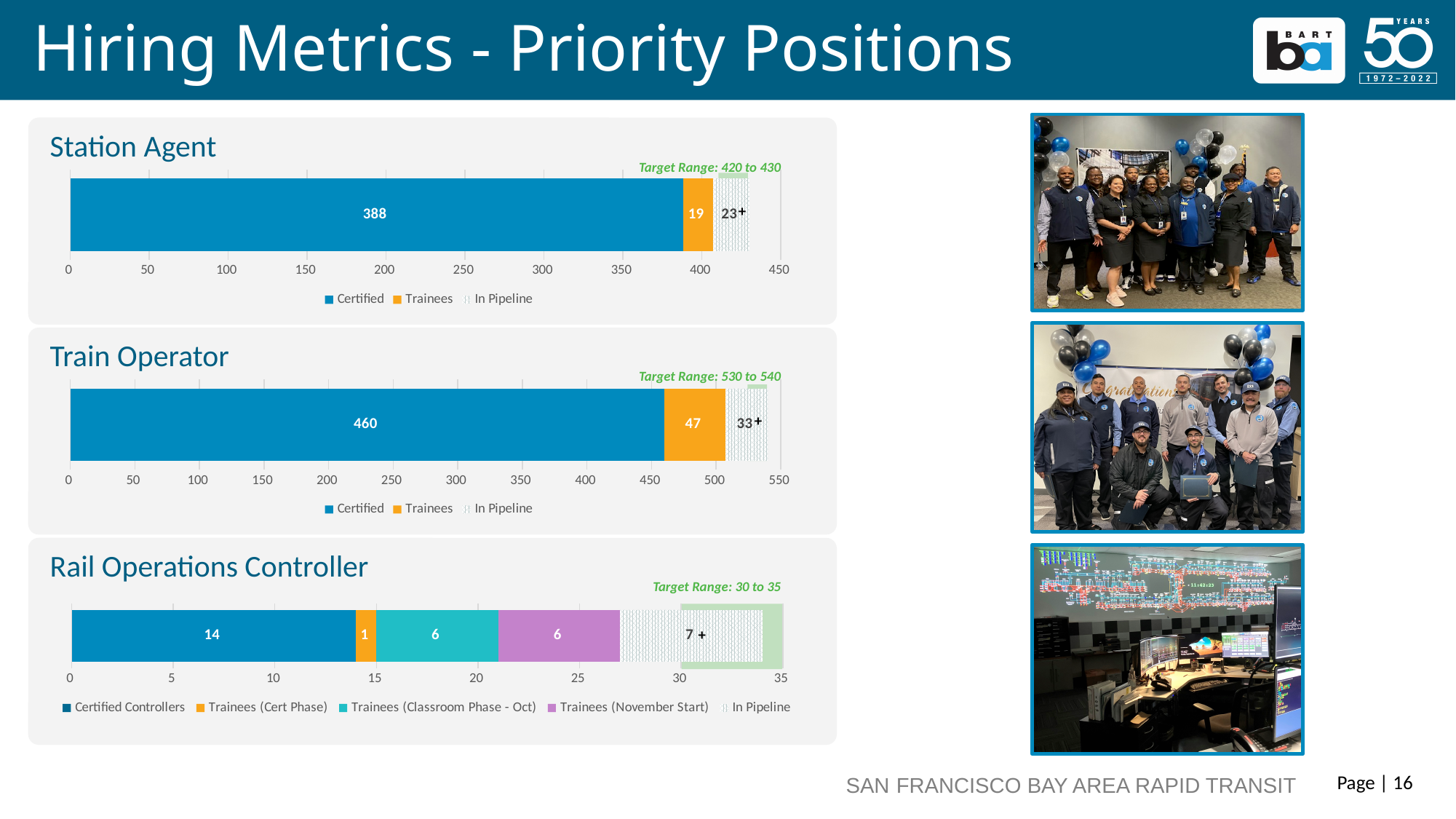
In the Station Agent chart, what is the value for Trainees? 19 In the Train Operator chart, what is the combined total of Certified and Trainees? 507 What type of chart is the Train Operator chart? Stacked bar chart In the Station Agent chart, what is the difference between Certified and Trainees? 369 In the Rail Operations Controller chart, what is the combined total of Certified Controllers and all three trainee groups? 27 In the Rail Operations Controller chart, what is the value for Trainees (Cert Phase)? 1 In the Train Operator chart, what is the value for Certified? 460 In the Rail Operations Controller chart, what is the value for Certified Controllers? 14 How many series does the legend of the Rail Operations Controller chart list? 5 What target range is shown on the Rail Operations Controller chart? 30 to 35 In the Station Agent chart, what is the value for Certified? 388 In the Train Operator chart, what is the value for Trainees? 47